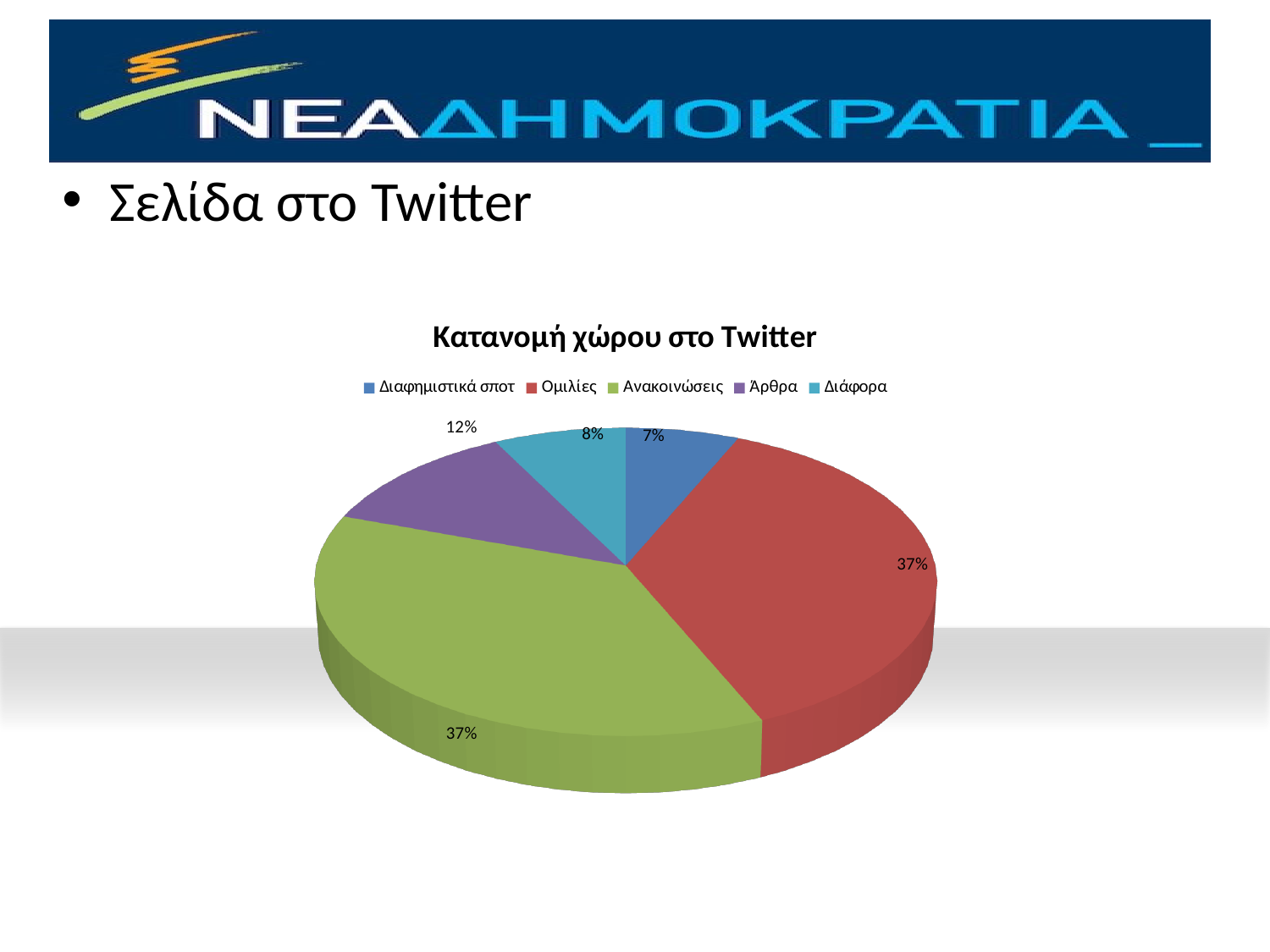
Which is larger, the share for Άρθρα or the share for Διάφορα? Άρθρα What share of the pie does Διαφημιστικά σποτ have? 7% What share of the pie does Διάφορα have? 8% What is the title of the chart? Κατανομή χώρου στο Twitter What share of the pie does Άρθρα have? 12% What is the difference between the share for Ομιλίες and the share for Άρθρα? 25% What is the difference between the share for Άρθρα and the share for Διαφημιστικά σποτ? 5% What kind of chart is shown on the slide? Pie chart Which category has the smallest share of the pie? Διαφημιστικά σποτ Which colour represents Ανακοινώσεις in the chart? Green How many categories does the legend of the chart list? 5